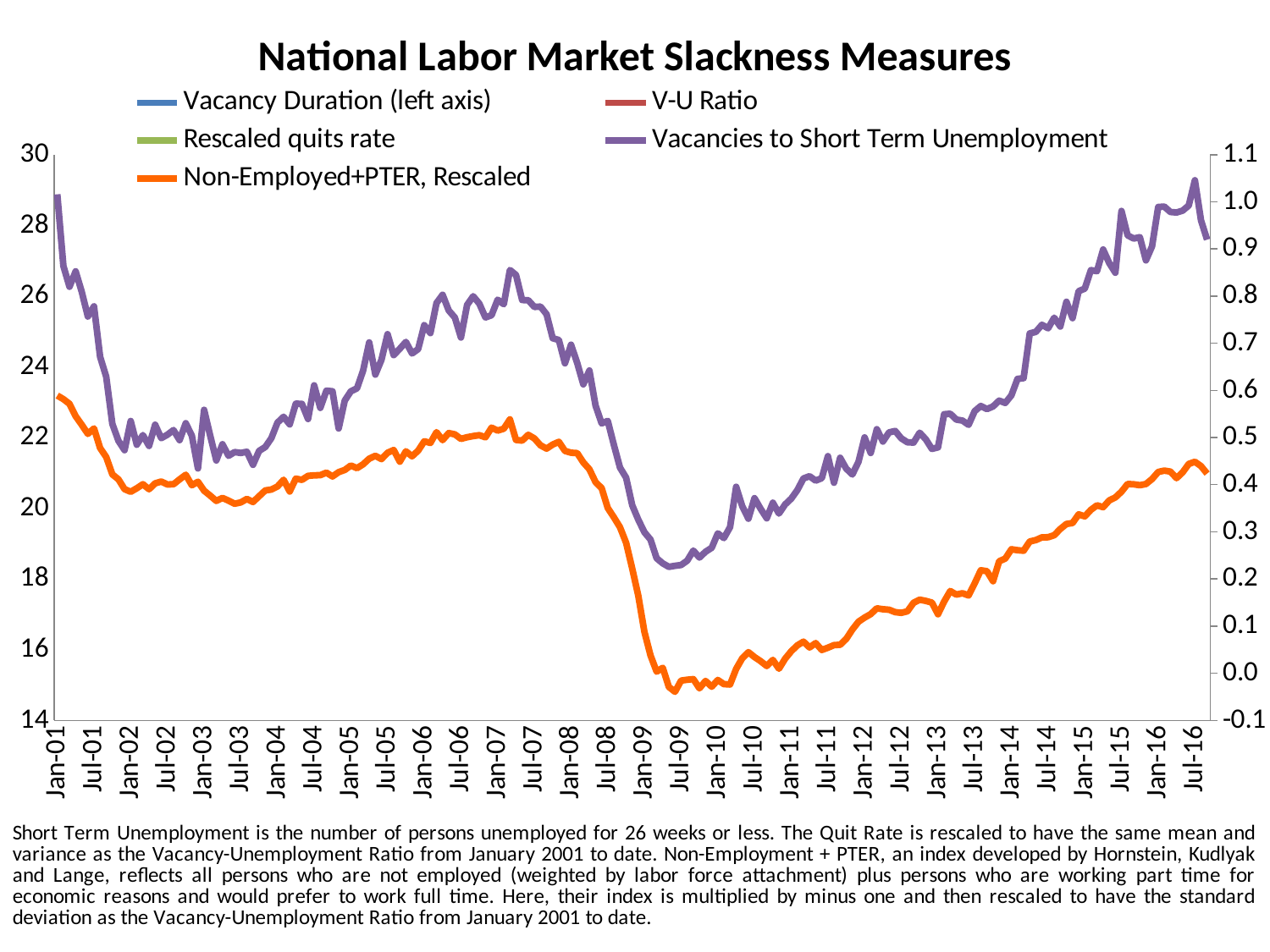
Is the value of the Non-Employed+PTER, Rescaled line at Jul-09 greater or less than 16 on the left axis? less Does the Vacancies to Short Term Unemployment line rise or fall between Jan-09 and Jan-16? rise At Jan-16, which line is plotted higher on the chart: Vacancies to Short Term Unemployment or Non-Employed+PTER, Rescaled? Vacancies to Short Term Unemployment How many series does the legend list? 5 Is the value of the Vacancies to Short Term Unemployment line at Jan-16 greater or less than 0.9 on the right axis? greater Is the value of the Vacancies to Short Term Unemployment line at Jul-09 greater or less than 0.3 on the right axis? less Which legend entry is marked as using the left axis? Vacancy Duration (left axis) What is the title of the chart? National Labor Market Slackness Measures Around which date does the Non-Employed+PTER, Rescaled line reach its lowest point? Jul-09 What kind of chart is shown on the slide? line chart Does the Non-Employed+PTER, Rescaled line rise or fall between Jan-07 and Jul-09? fall